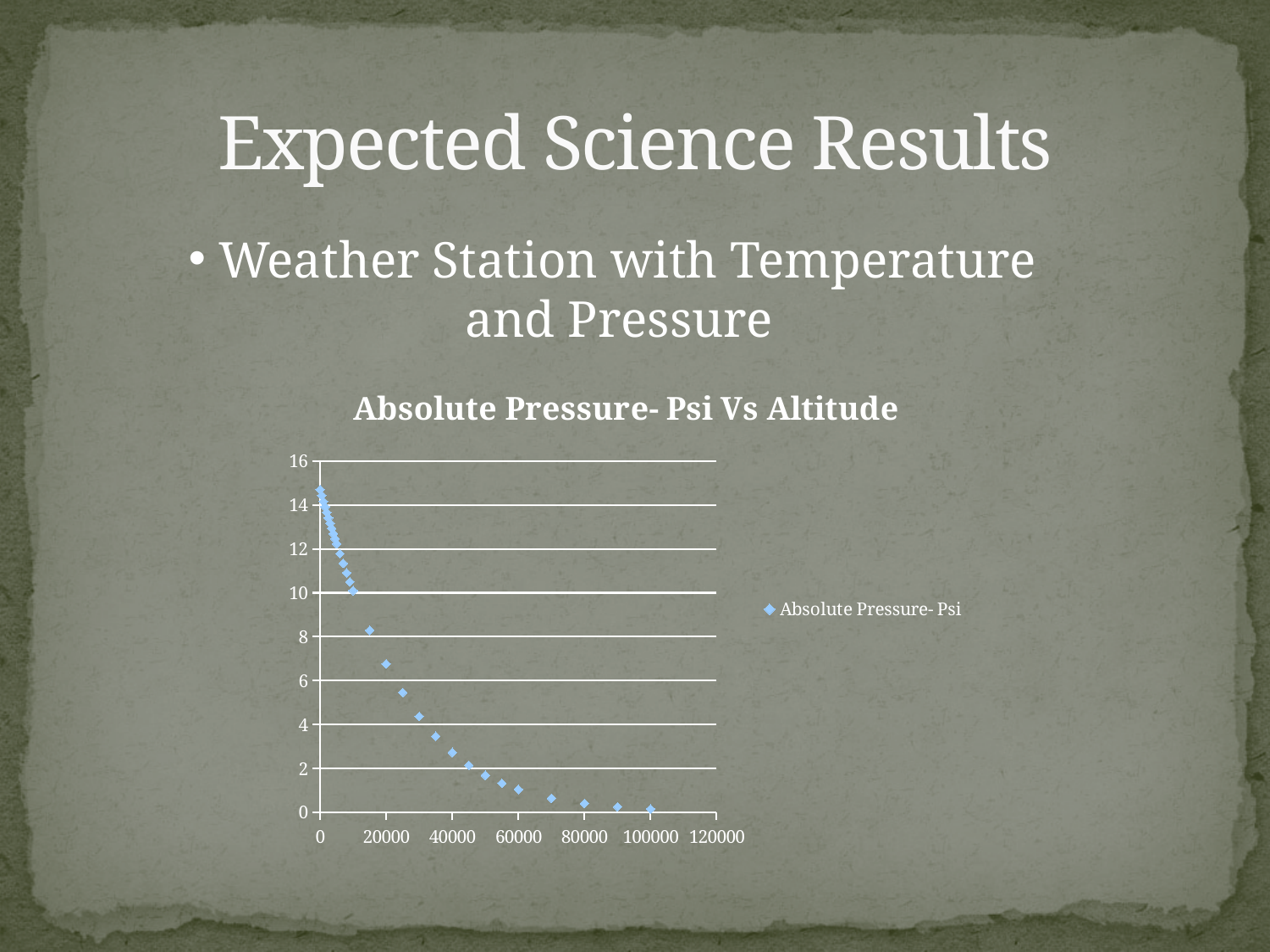
Is the absolute pressure at altitude 40000 greater or less than 4? less Is the absolute pressure at altitude 0 greater or less than 14? greater How many series does the chart legend list? 1 At which plotted altitude is the absolute pressure lowest? 100000 Which is larger, the absolute pressure at altitude 20000 or at altitude 60000? altitude 20000 At which altitude is the absolute pressure highest? 0 What is the name of the series shown in the legend? Absolute Pressure- Psi Is the absolute pressure at altitude 20000 greater or less than 8? less What kind of chart is shown on the slide? scatter chart What is the title of the chart? Absolute Pressure- Psi Vs Altitude Do the plotted values rise or fall as altitude increases along the x axis? fall